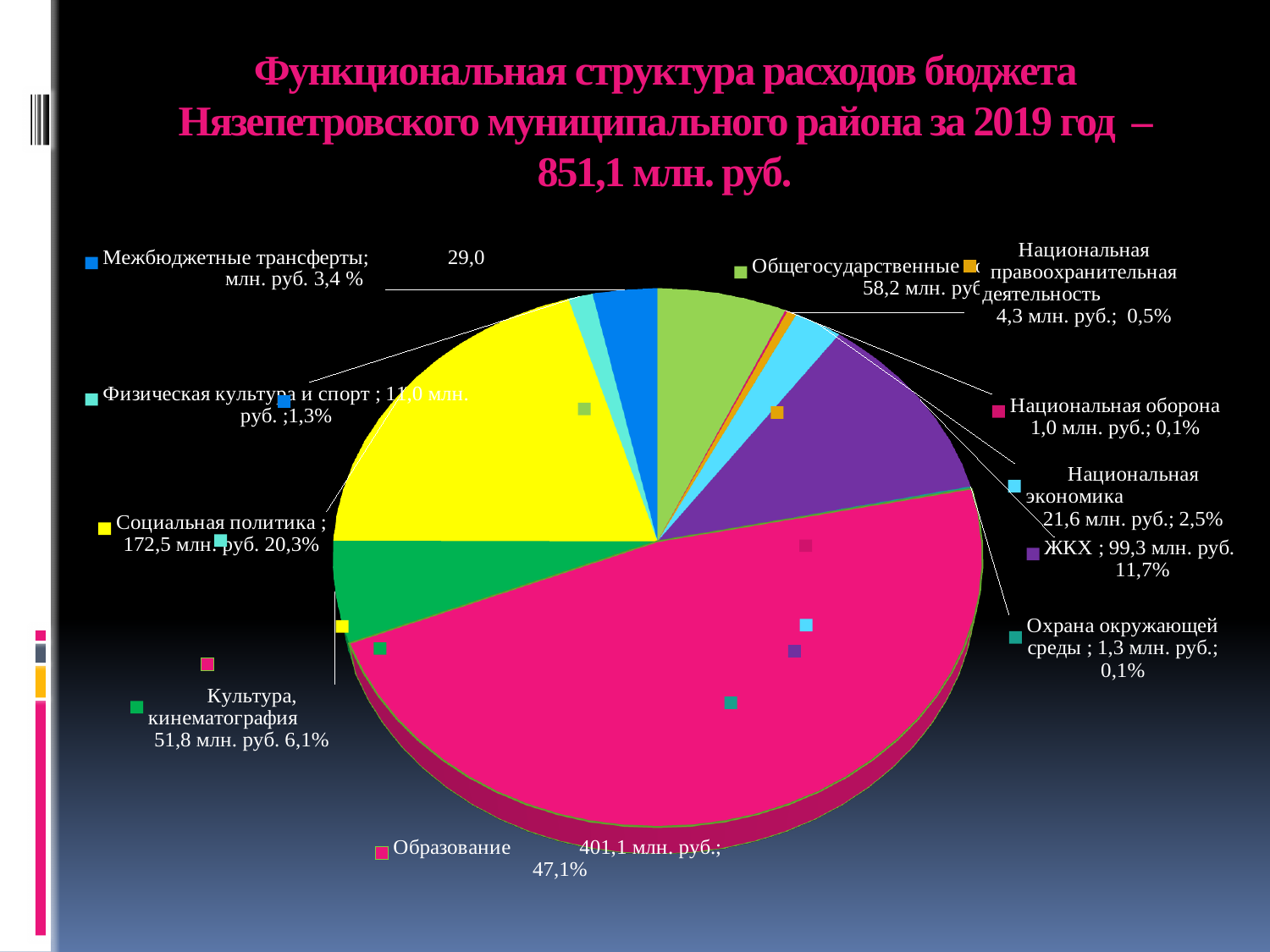
Which category has the largest slice of the pie? Образование What kind of chart is shown on the slide? pie chart Which category has the smallest value in млн. руб.? Национальная оборона How many categories are shown in the pie chart? 11 What total budget expenditure is stated in the slide title? 851,1 млн. руб. What is the difference in млн. руб. between Образование and Социальная политика? 228,6 млн. руб. What is the value for Социальная политика? 172,5 млн. руб. What share of the pie does Образование take? 47,1% Which is larger, ЖКХ or Культура, кинематография? ЖКХ What percentage is shown for ЖКХ? 11,7% What is the value for Национальная экономика? 21,6 млн. руб. What is the value for Образование? 401,1 млн. руб.